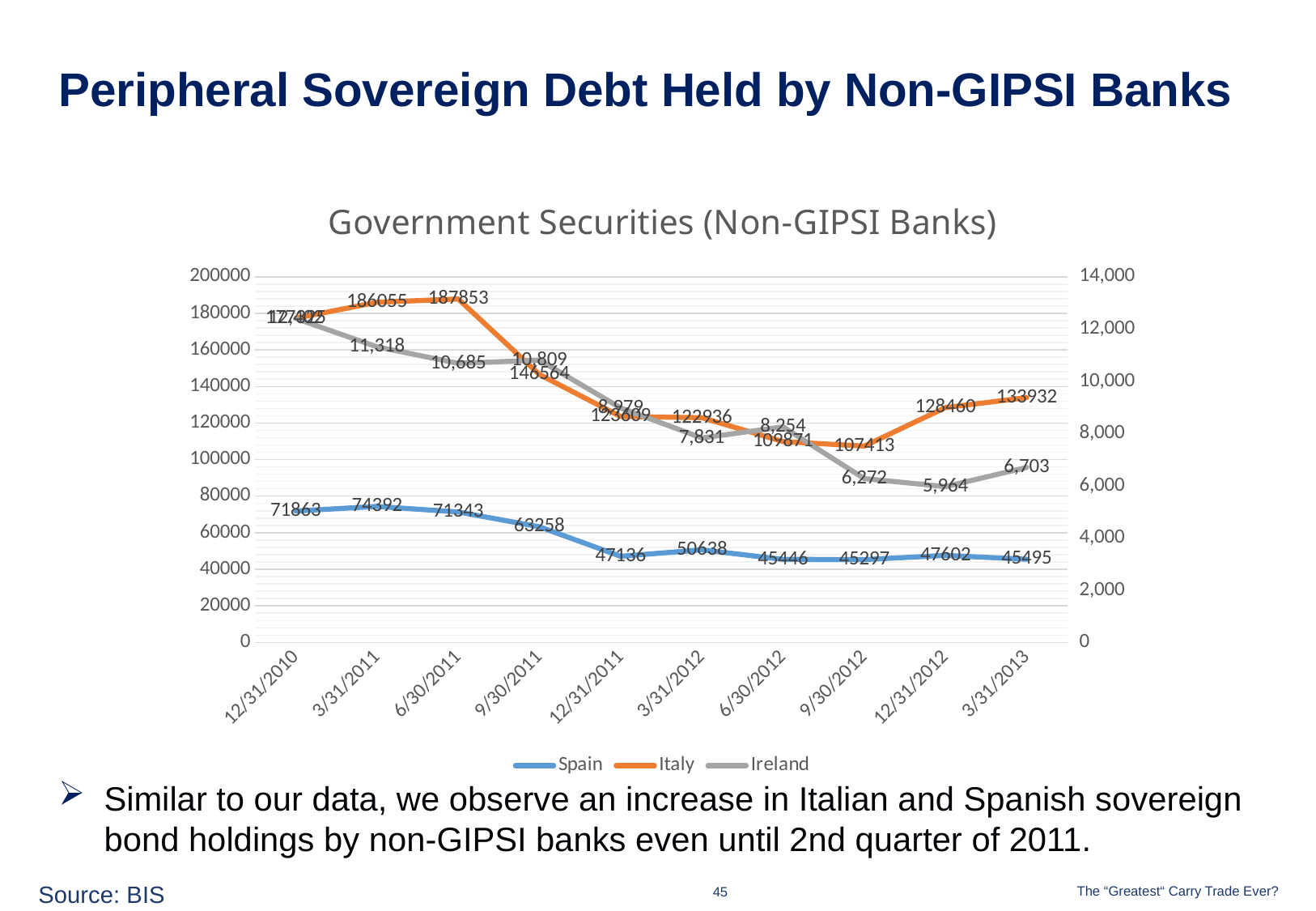
What is the value for Ireland on 12/31/2012? 5,964 What is the value for Italy on 6/30/2011? 187853 What kind of chart is shown on the slide? line chart How many dates are plotted along the x axis? 10 On which date does Ireland reach its lowest value? 12/31/2012 What is the value for Italy on 9/30/2011? 146564 What is the difference between Italy's value on 3/31/2013 and on 12/31/2012? 5472 What is the value for Spain on 3/31/2011? 74392 On which date does Italy reach its highest value? 6/30/2011 How many series does the legend list? 3 What is the title of the chart? Government Securities (Non-GIPSI Banks) Which is larger for Spain: the value on 9/30/2011 or on 12/31/2011? 9/30/2011